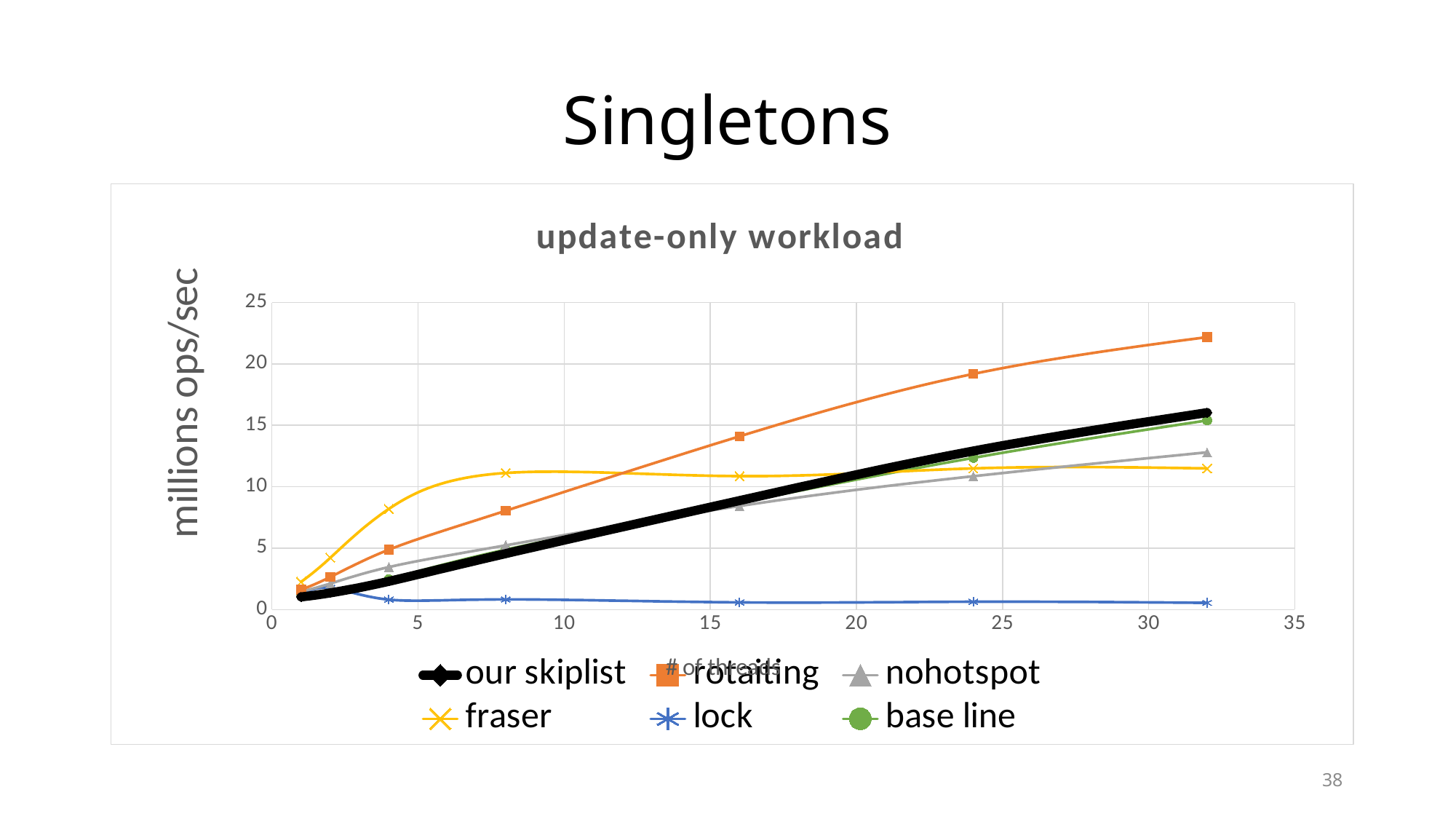
What is the title of the chart? update-only workload Which series has the lowest value at 32 threads? lock Is the value for fraser at 8 threads greater or less than 10? greater Does the rotaiting series rise or fall as the number of threads increases? rise Is the value for lock at 32 threads greater or less than 5? less At 32 threads, which is larger: our skiplist or nohotspot? our skiplist How many series does the legend list? 6 At 8 threads, which is larger: fraser or rotaiting? fraser Is the value for rotaiting at 32 threads greater or less than 20? greater Which series has the highest value at 32 threads? rotaiting What kind of chart is shown on the slide? line chart What is the label on the vertical axis? millions ops/sec